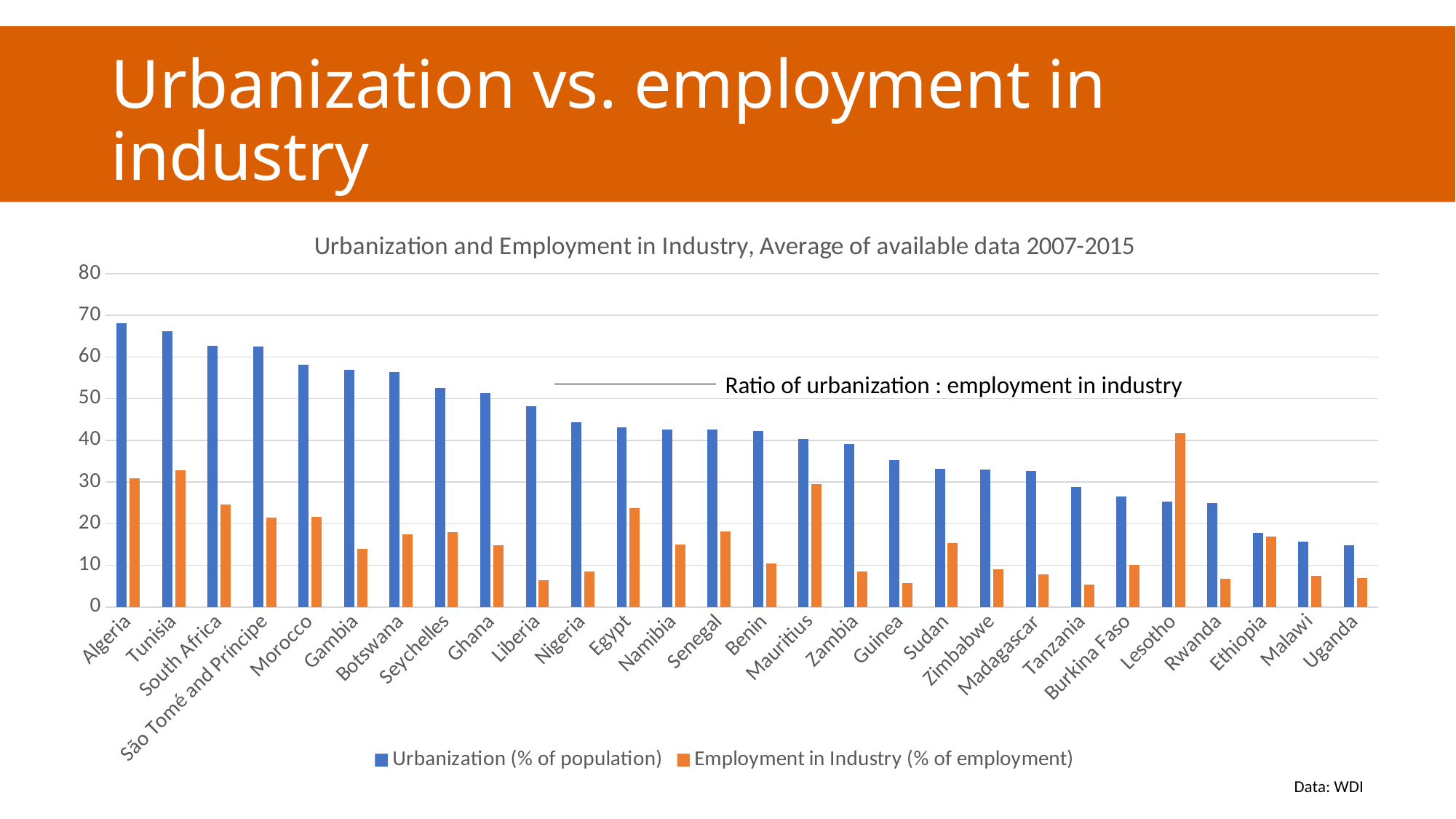
For Lesotho, which is larger: Urbanization (% of population) or Employment in Industry (% of employment)? Employment in Industry (% of employment) What is the title of the chart? Urbanization and Employment in Industry, Average of available data 2007-2015 Which country has the highest Urbanization (% of population) value? Algeria Is the Urbanization (% of population) value for Uganda greater or less than 20? less Is the Employment in Industry (% of employment) value for Liberia greater or less than 10? less Is the Urbanization (% of population) value for Algeria greater or less than 60? greater How many countries are shown on the x axis? 28 What kind of chart is shown on the slide? Bar chart Do the Urbanization (% of population) values rise or fall from left to right along the x axis? fall How many series does the legend list? 2 Which country has the highest Employment in Industry (% of employment) value? Lesotho